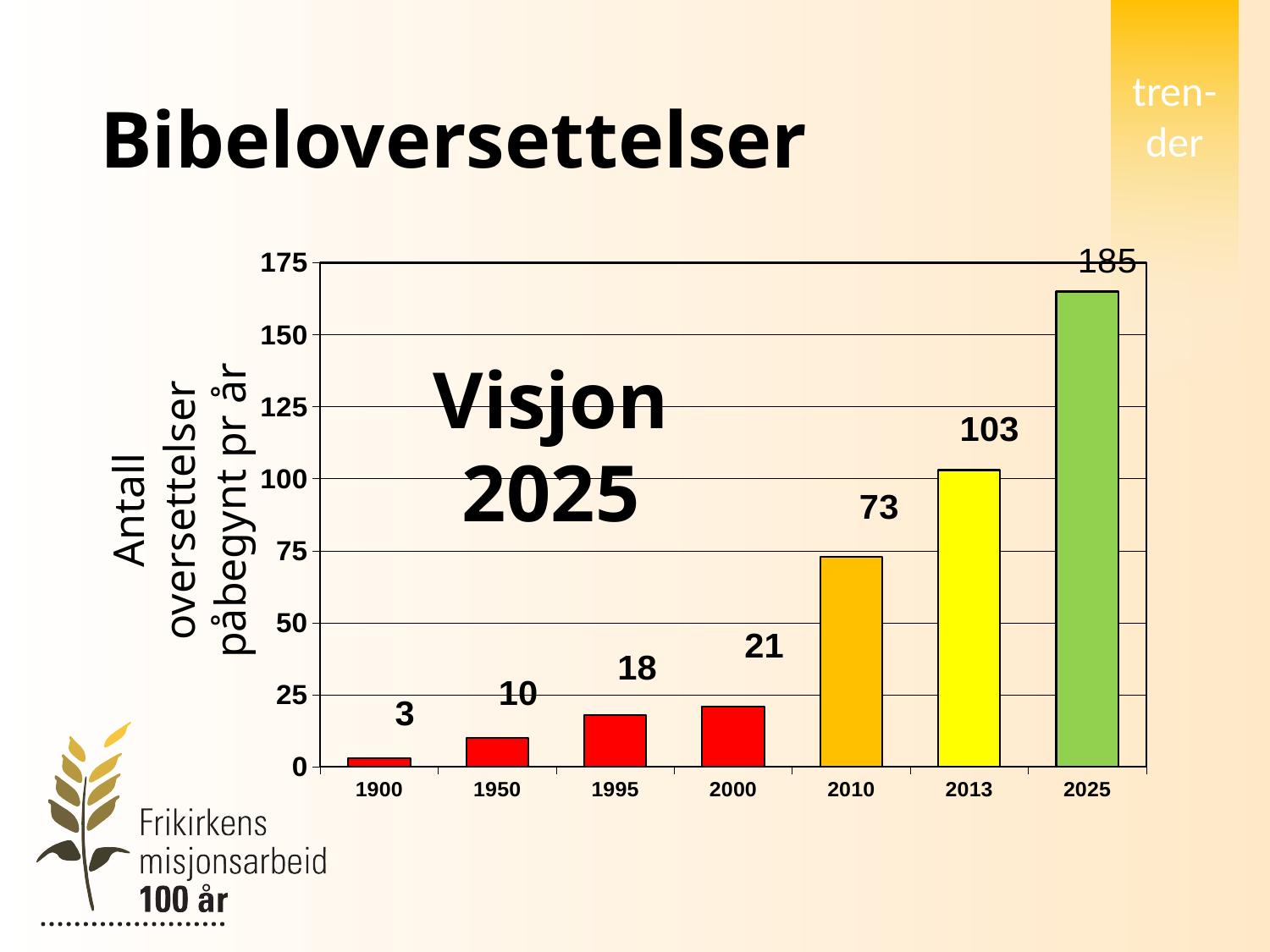
Which year has the lowest value? 1900 What kind of chart is shown? bar chart What is the value for 2010? 73 What is the value for 1950? 10 What is the difference between the values for 2013 and 2010? 30 Do the values rise or fall from 1900 to 2025? rise What is the title of the slide? Bibeloversettelser What is the value labelled on the 2025 bar? 185 Which year has the highest value? 2025 Is the value for 2013 greater or less than 100? greater How many years are shown on the x axis? 7 Which is larger, the value for 1995 or the value for 2000? 2000